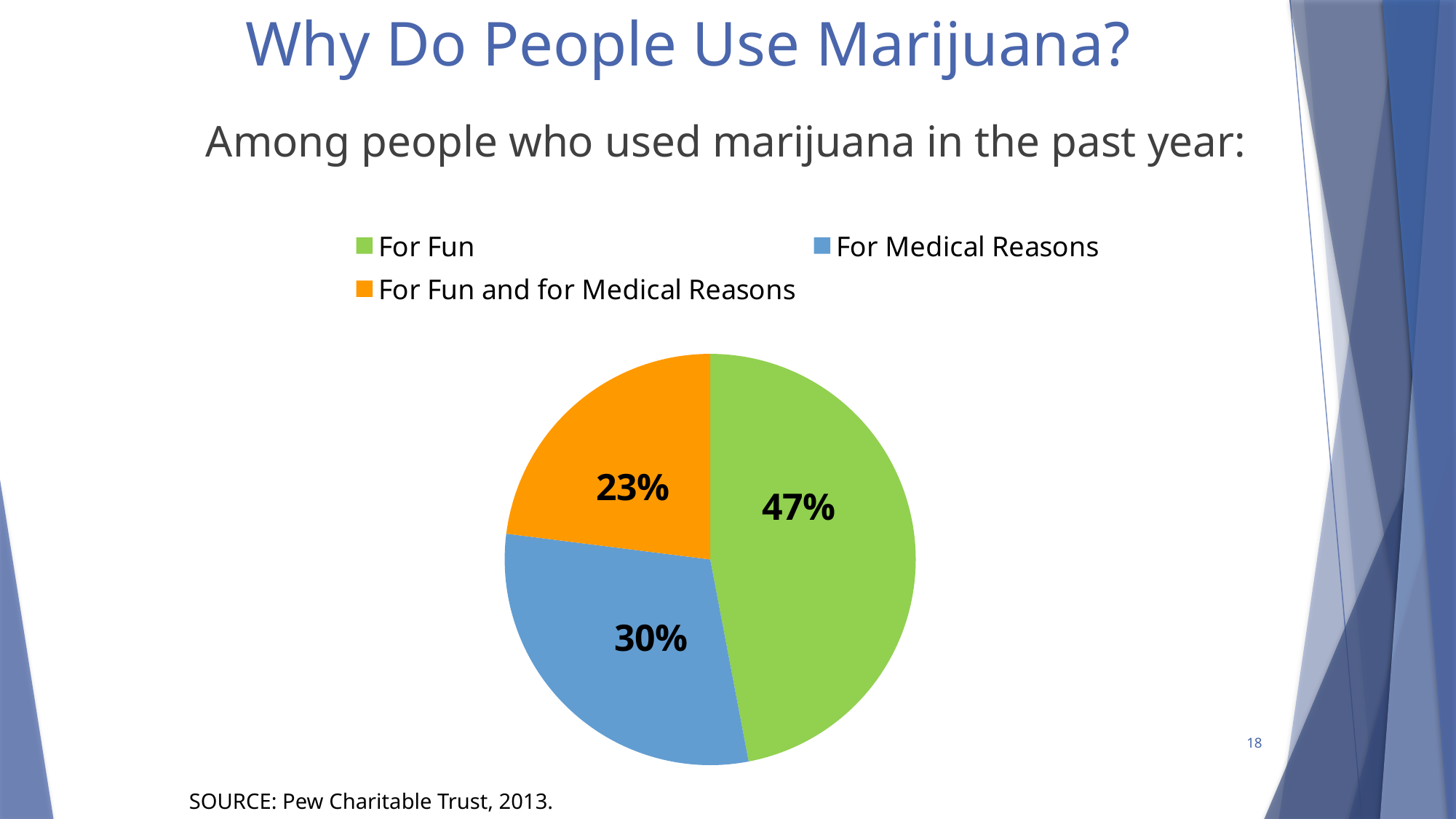
What source is cited for the chart data? Pew Charitable Trust, 2013 What kind of chart is shown on the slide? pie chart What colour is the For Fun slice? green What is the difference in percentage points between For Medical Reasons and For Fun and for Medical Reasons? 7 How many slices does the pie chart have? 3 What is the difference in percentage points between For Fun and For Medical Reasons? 17 Which is larger: the share For Medical Reasons or the share For Fun and for Medical Reasons? For Medical Reasons What percentage of past-year marijuana users used it For Medical Reasons? 30% Which category has the smallest share of the pie? For Fun and for Medical Reasons Which category has the largest share of the pie? For Fun What percentage of past-year marijuana users used it For Fun and for Medical Reasons? 23% What percentage of past-year marijuana users used it For Fun? 47%